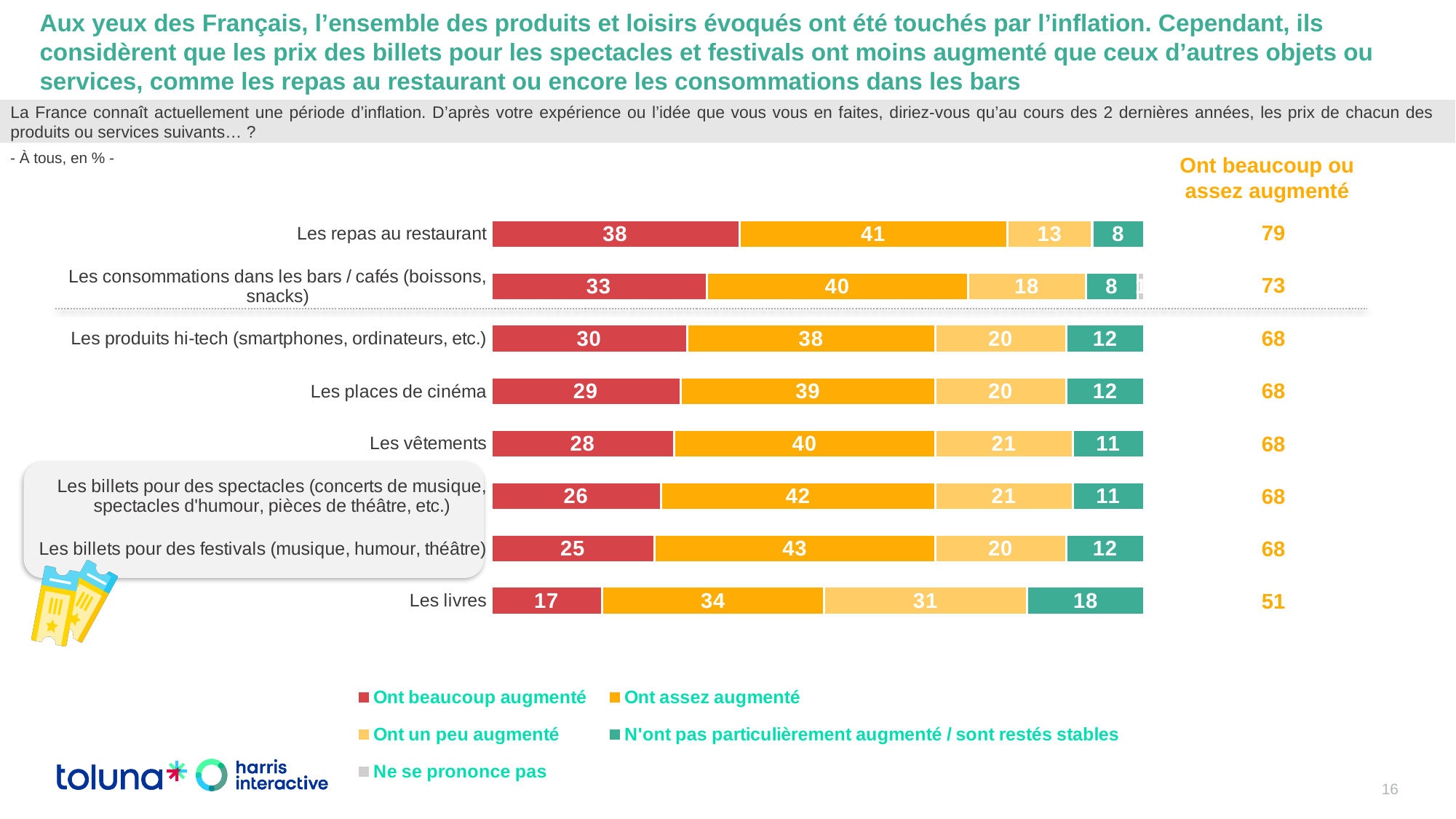
Which has the larger "Ont un peu augmenté" value: "Les livres" or "Les vêtements"? Les livres What is the total of the labelled segments in the bar for "Les repas au restaurant"? 100 What is the "Ont assez augmenté" value for "Les billets pour des festivals (musique, humour, théâtre)"? 43 What is the "N'ont pas particulièrement augmenté / sont restés stables" value for "Les livres"? 18 What percentage of respondents say prices for "Les repas au restaurant" "Ont beaucoup augmenté"? 38 Which category has the highest "Ont beaucoup augmenté" value? Les repas au restaurant What is the difference between the "Ont beaucoup augmenté" values for "Les repas au restaurant" and "Les livres"? 21 Which category has the lowest "Ont beaucoup augmenté" value? Les livres What kind of chart is shown on the slide? Stacked bar chart How many product or service categories are shown in the chart? 8 How many series does the legend list? 5 What is the "Ont beaucoup ou assez augmenté" figure shown for "Les consommations dans les bars / cafés (boissons, snacks)"? 73